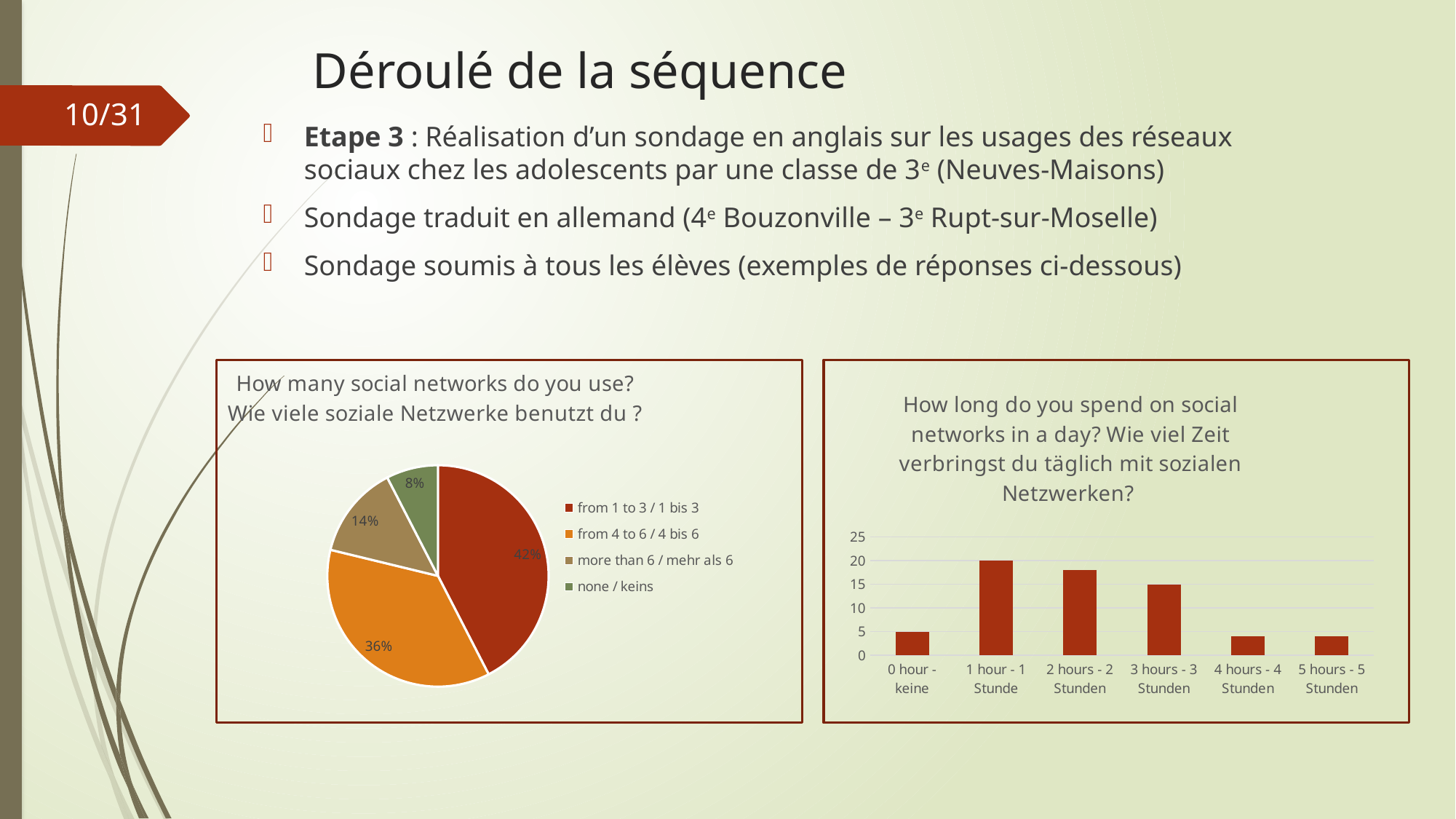
How many categories does the legend of the pie chart 'How many social networks do you use?' list? 4 In the bar chart 'How long do you spend on social networks in a day?', what is the value for '3 hours - 3 Stunden'? 15 How many categories are shown on the x axis of the bar chart 'How long do you spend on social networks in a day?'? 6 In the bar chart 'How long do you spend on social networks in a day?', what is the value for '1 hour - 1 Stunde'? 20 In the pie chart 'How many social networks do you use?', what share is shown for 'more than 6 / mehr als 6'? 14% What kind of chart is the chart on the right, 'How long do you spend on social networks in a day?'? bar chart In the pie chart 'How many social networks do you use?', what is the difference in percentage points between 'from 1 to 3 / 1 bis 3' and 'from 4 to 6 / 4 bis 6'? 6 In the bar chart 'How long do you spend on social networks in a day?', is the value for '2 hours - 2 Stunden' greater or less than 15? greater In the pie chart 'How many social networks do you use?', which category has the largest slice? from 1 to 3 / 1 bis 3 In the pie chart 'How many social networks do you use?', what share is shown for 'from 1 to 3 / 1 bis 3'? 42% In the bar chart 'How long do you spend on social networks in a day?', which category has the highest bar? 1 hour - 1 Stunde In the pie chart 'How many social networks do you use?', which category has the smallest slice? none / keins